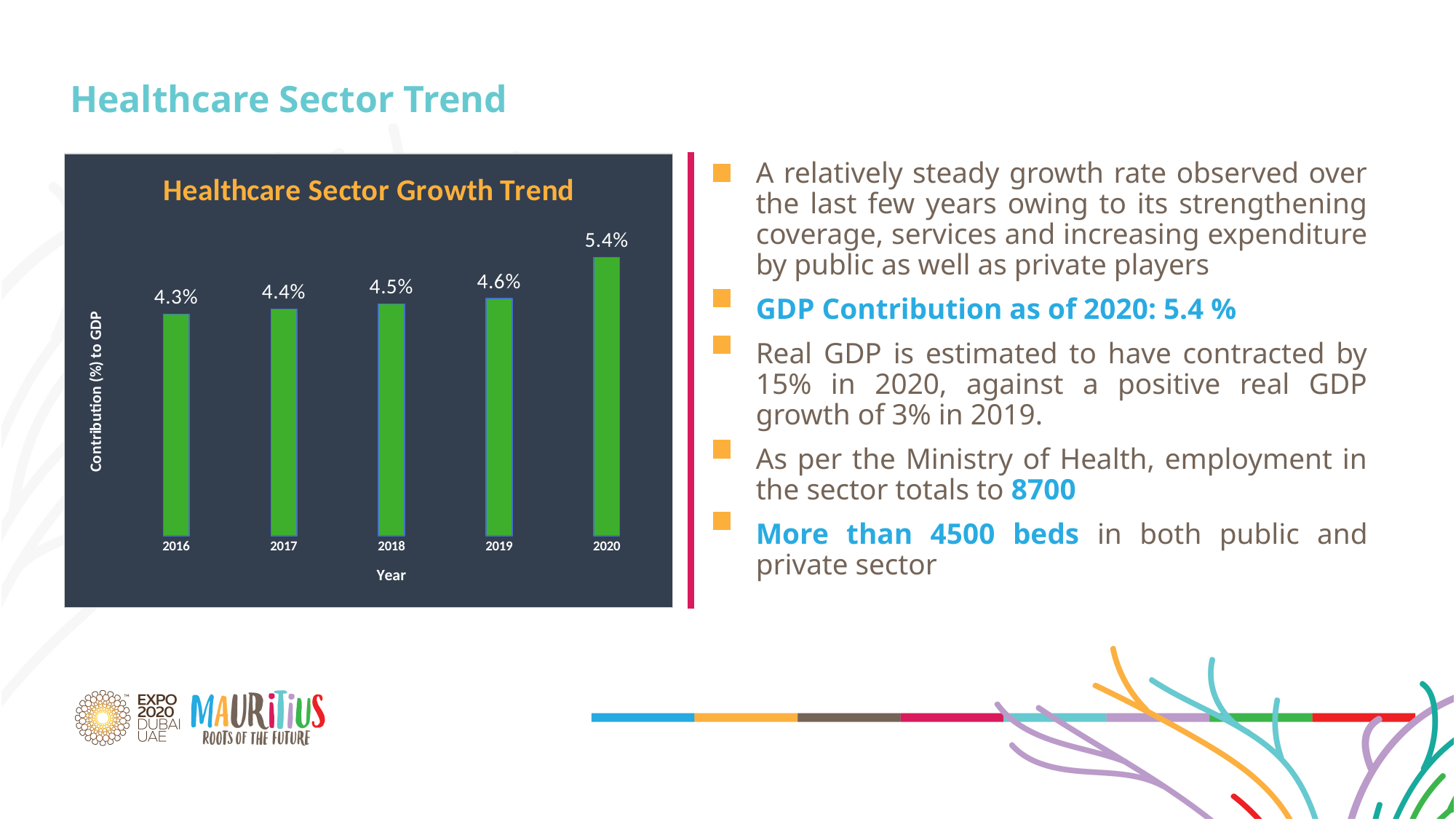
Do the values rise or fall from 2016 to 2020? rise What value is shown for 2020 in the Healthcare Sector Growth Trend chart? 5.4% What is the difference between the 2020 and 2019 values? 0.8% Which is larger, the value for 2019 or the value for 2017? 2019 What is the contribution (%) to GDP shown for 2018? 4.5% What is the difference between the 2017 and 2016 values? 0.1% How many years are shown on the x axis of the chart? 5 What type of chart is shown on the slide? bar chart Which year has the highest contribution to GDP? 2020 Which year has the lowest contribution to GDP? 2016 What is the title of the chart? Healthcare Sector Growth Trend What is the value for 2016? 4.3%